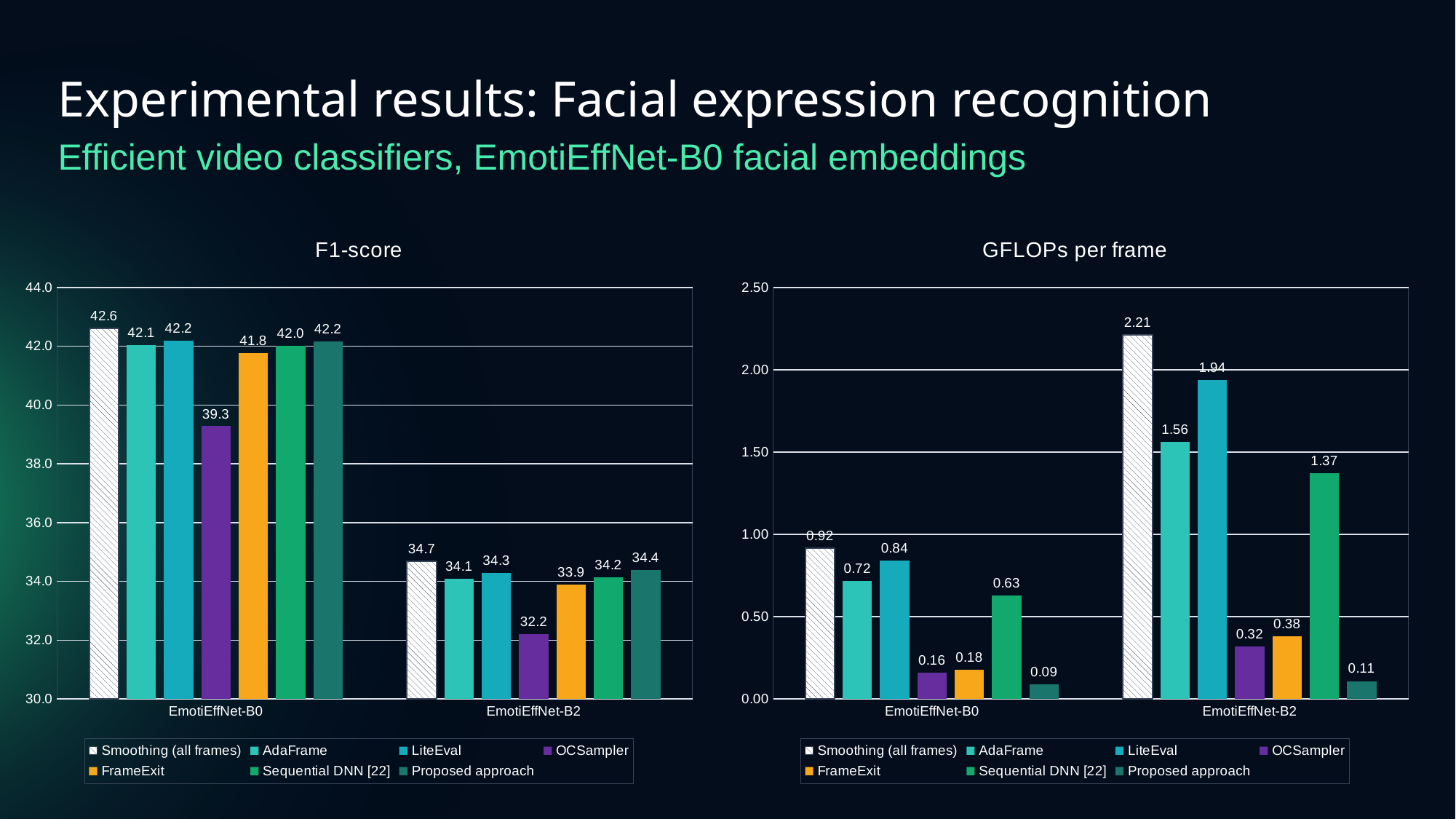
In the GFLOPs per frame chart, which series has the highest value for EmotiEffNet-B0? Smoothing (all frames) In the F1-score chart, what is the F1-score of the Proposed approach for EmotiEffNet-B0? 42.2 In the F1-score chart, which series has the lowest F1-score for EmotiEffNet-B2? OCSampler In the GFLOPs per frame chart, is the value for Sequential DNN [22] on EmotiEffNet-B2 greater or less than 1.00? greater In the F1-score chart, which is larger for EmotiEffNet-B0: the F1-score of FrameExit or of Sequential DNN [22]? Sequential DNN [22] In the GFLOPs per frame chart, what is the value for Smoothing (all frames) on EmotiEffNet-B2? 2.21 What is the title of the chart on the right side of the slide? GFLOPs per frame How many categories are shown on the x axis of the GFLOPs per frame chart? 2 How many series does the legend of the F1-score chart list? 7 In the GFLOPs per frame chart, what is the difference between LiteEval and the Proposed approach for EmotiEffNet-B2? 1.83 In the F1-score chart, what is the difference between the Smoothing (all frames) F1-score for EmotiEffNet-B0 and for EmotiEffNet-B2? 7.9 What kind of chart is the GFLOPs per frame chart? Bar chart